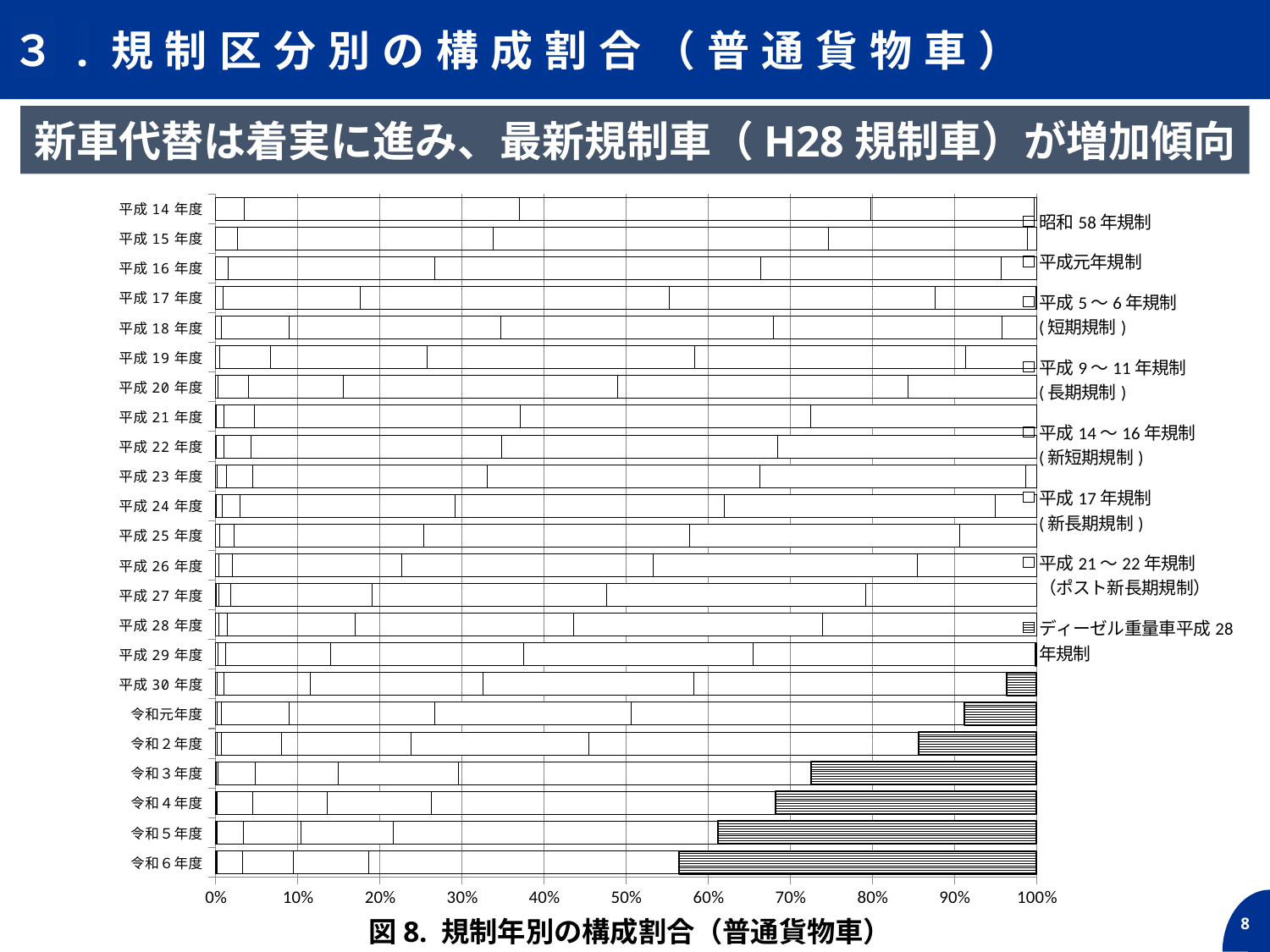
Is the share of ディーゼル重量車平成28年規制 for 令和3年度 greater or less than 20%? greater Which fiscal year has the largest share of ディーゼル重量車平成28年規制? 令和6年度 What is the maximum value shown on the horizontal axis of the chart? 100% Which has the larger share of ディーゼル重量車平成28年規制: 令和6年度 or 令和元年度? 令和6年度 How many fiscal-year categories are plotted on the vertical axis of the chart? 23 What kind of chart is shown on the slide? Stacked bar chart What is the caption of the chart shown below the plot? 図8. 規制年別の構成割合（普通貨物車） Which fiscal year is the first (topmost) category on the chart? 平成14年度 Is the share of ディーゼル重量車平成28年規制 for 令和6年度 greater or less than 30%? greater Is the share of ディーゼル重量車平成28年規制 for 令和元年度 greater or less than 20%? less How many series does the chart legend list? 8 Does the share of ディーゼル重量車平成28年規制 rise or fall from 平成30年度 to 令和6年度? rise